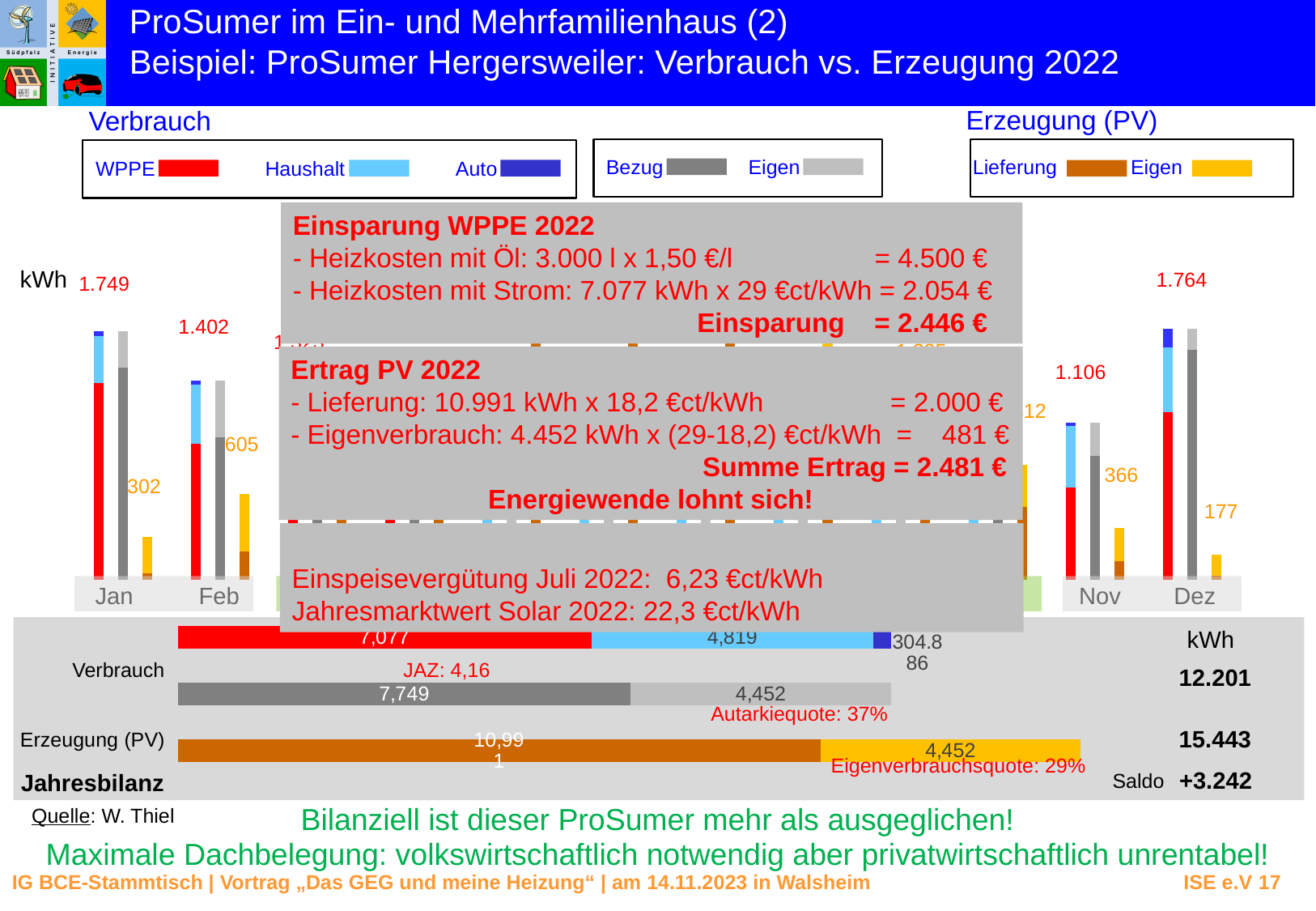
In the monthly chart, what is the Verbrauch value labelled above the January bars? 1.749 In the monthly chart, what is the PV value labelled for December (Dez)? 177 In the monthly chart, which of the visible months (Jan, Feb, Nov, Dez) has the highest labelled PV value? Feb In the Jahresbilanz bars at the bottom, what is the WPPE share of the Verbrauch bar? 7,077 In the monthly chart, what is the PV value labelled for February (Feb)? 605 In the monthly chart, which of the visible months (Jan, Feb, Nov, Dez) has the lowest labelled PV value? Dez How many series does the Verbrauch legend list? 3 In the Jahresbilanz bars at the bottom, what is the total Erzeugung (PV) in kWh? 15.443 In the Jahresbilanz bars at the bottom, what is the Eigen (yellow) share of the Erzeugung (PV) bar? 4,452 In the Jahresbilanz bars at the bottom, what is the Saldo shown? +3.242 In the Jahresbilanz bars at the bottom, what is the total Verbrauch in kWh? 12.201 In the monthly chart, what is the Verbrauch value labelled above the December (Dez) bars? 1.764